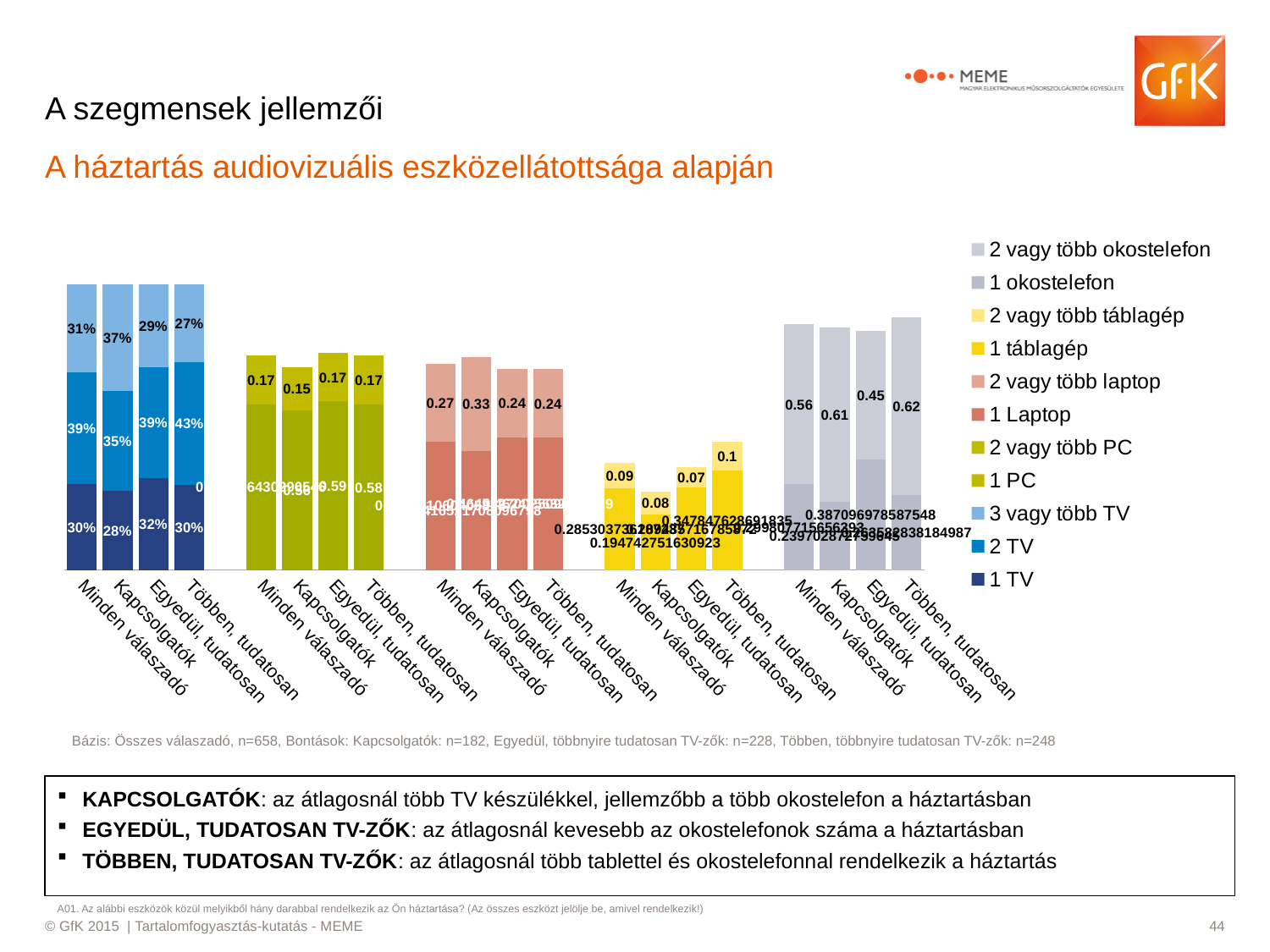
How many respondent segments are shown within each device group on the x axis? 4 What is the value of '2 vagy több táblagép' for 'Többen, tudatosan'? 0.1 Which is larger: the '2 TV' share for 'Többen, tudatosan' or for 'Kapcsolgatók'? Többen, tudatosan Which segment has the lowest share of '1 TV' households? Kapcsolgatók What is the value of '2 vagy több laptop' for 'Kapcsolgatók'? 0.33 What share of 'Kapcsolgatók' households have 3 or more TVs ('3 vagy több TV')? 37% How many series does the legend list? 11 What is the difference between the '2 vagy több okostelefon' values for 'Kapcsolgatók' and 'Egyedül, tudatosan'? 0.16 What kind of chart is shown on the slide? Stacked bar chart What is the total of the stacked TV bar for 'Minden válaszadó' (1 TV + 2 TV + 3 vagy több TV)? 100% What is the value of '2 vagy több okostelefon' for 'Egyedül, tudatosan'? 0.45 Which segment has the highest value for '2 vagy több okostelefon'? Többen, tudatosan